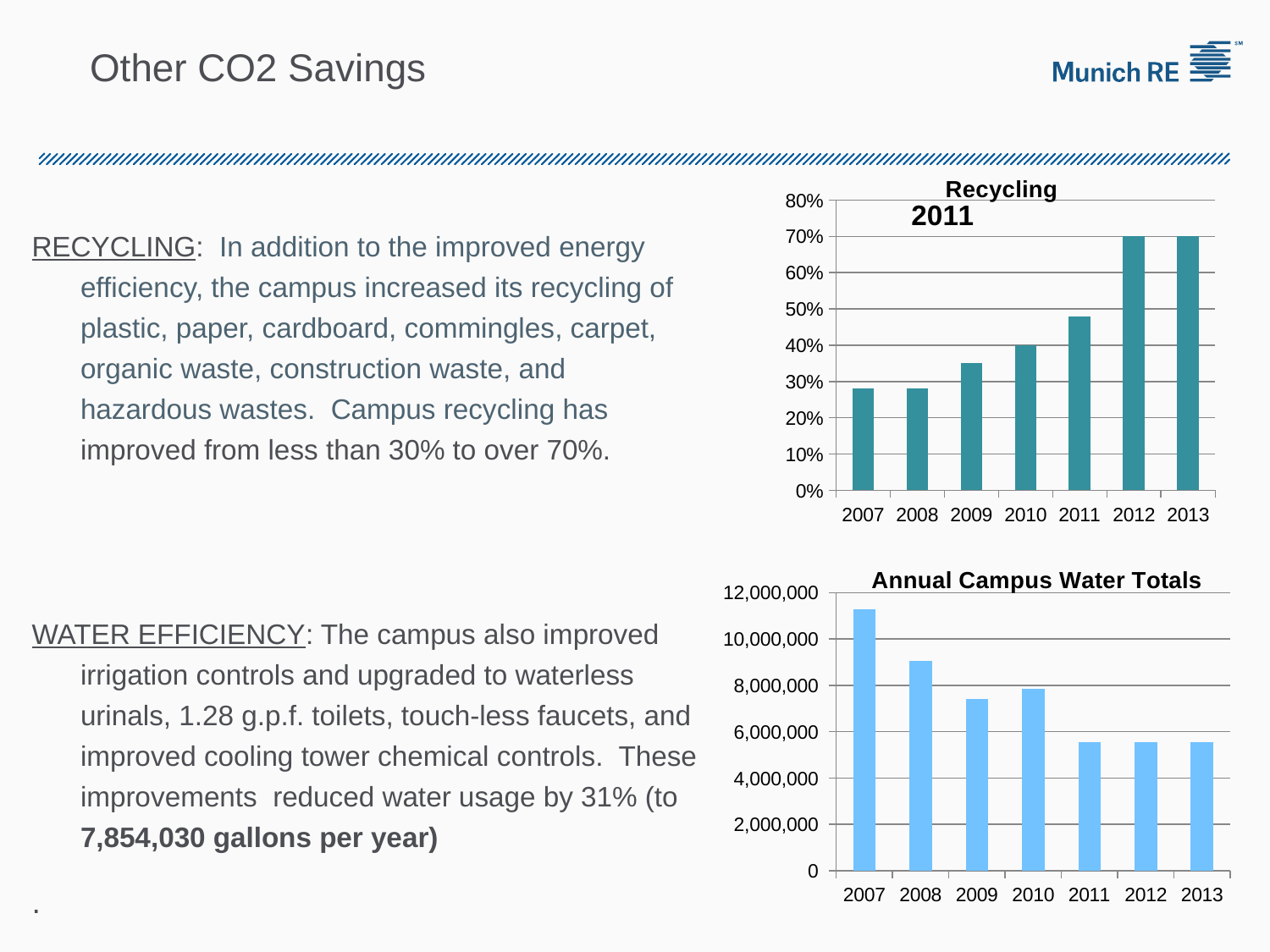
In the Recycling chart, is the value for 2007 greater or less than 30%? less In the Annual Campus Water Totals chart, which is larger, the value for 2008 or the value for 2010? 2008 What kind of chart is the Annual Campus Water Totals chart? bar chart In the Recycling chart, how many years are shown on the x axis? 7 In the Annual Campus Water Totals chart, is the value for 2007 greater or less than 10,000,000? greater What is the title of the upper chart on the slide? Recycling In the Annual Campus Water Totals chart, is the value for 2011 greater or less than 6,000,000? less In the Annual Campus Water Totals chart, do the values generally rise or fall from 2007 to 2013? fall In the Recycling chart, do the values generally rise or fall from 2007 to 2013? rise In the Recycling chart, which is larger, the value for 2009 or the value for 2011? 2011 In the Annual Campus Water Totals chart, which year has the highest value? 2007